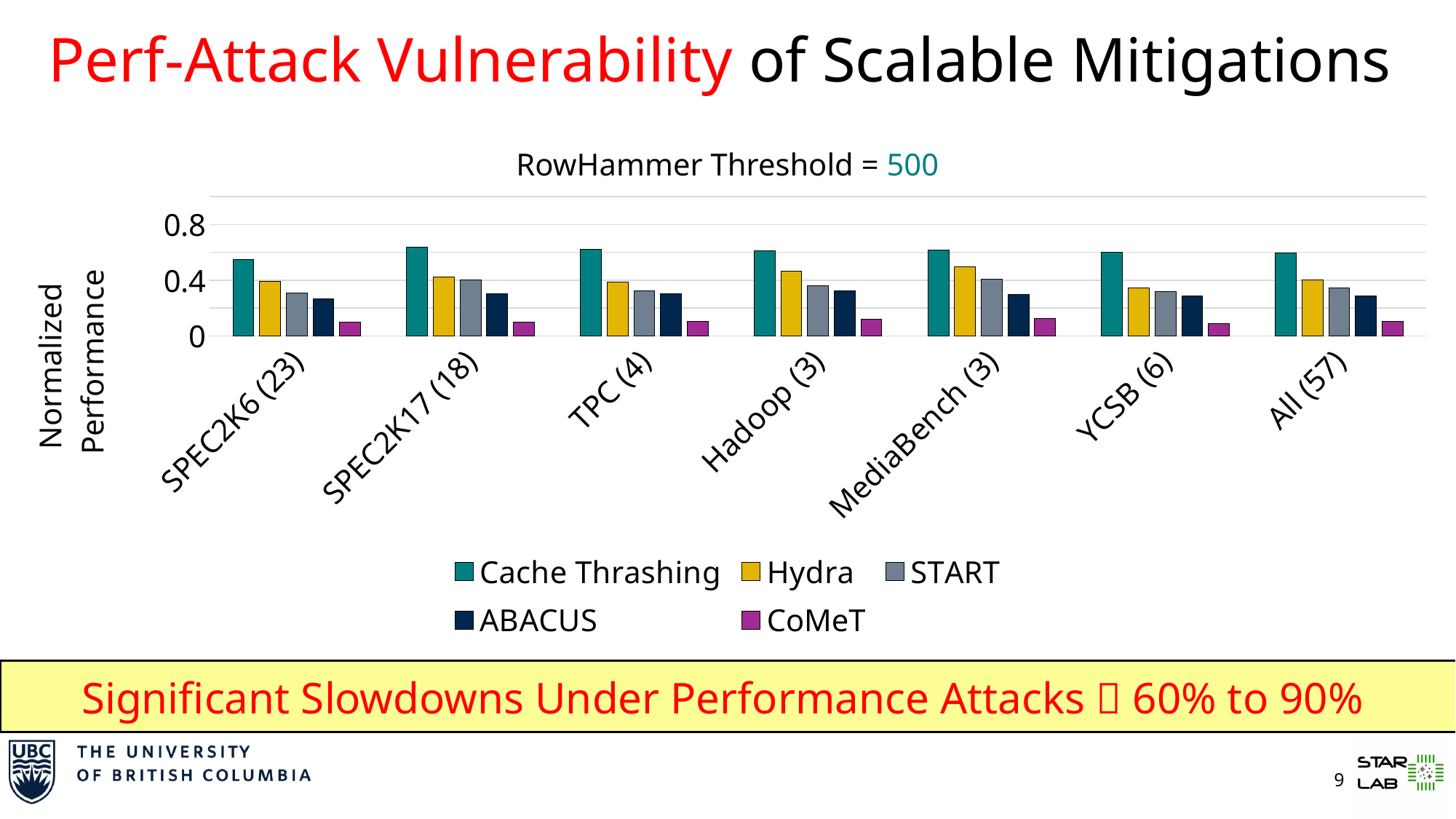
Which series has the highest normalized performance for All (57)? Cache Thrashing How many series does the chart's legend list? 5 What is the label of the chart's y axis? Normalized Performance Which series has the lowest normalized performance for Hadoop (3)? CoMeT For SPEC2K17 (18), which is larger: the Hydra value or the CoMeT value? Hydra Is the Cache Thrashing value for TPC (4) greater or less than 0.4? greater What is the title of the chart? RowHammer Threshold = 500 How many workload categories are shown on the x axis of the chart? 7 What kind of chart is shown on the slide? bar chart Is the CoMeT value for YCSB (6) greater or less than 0.4? less Is the ABACUS value for SPEC2K6 (23) greater or less than 0.4? less